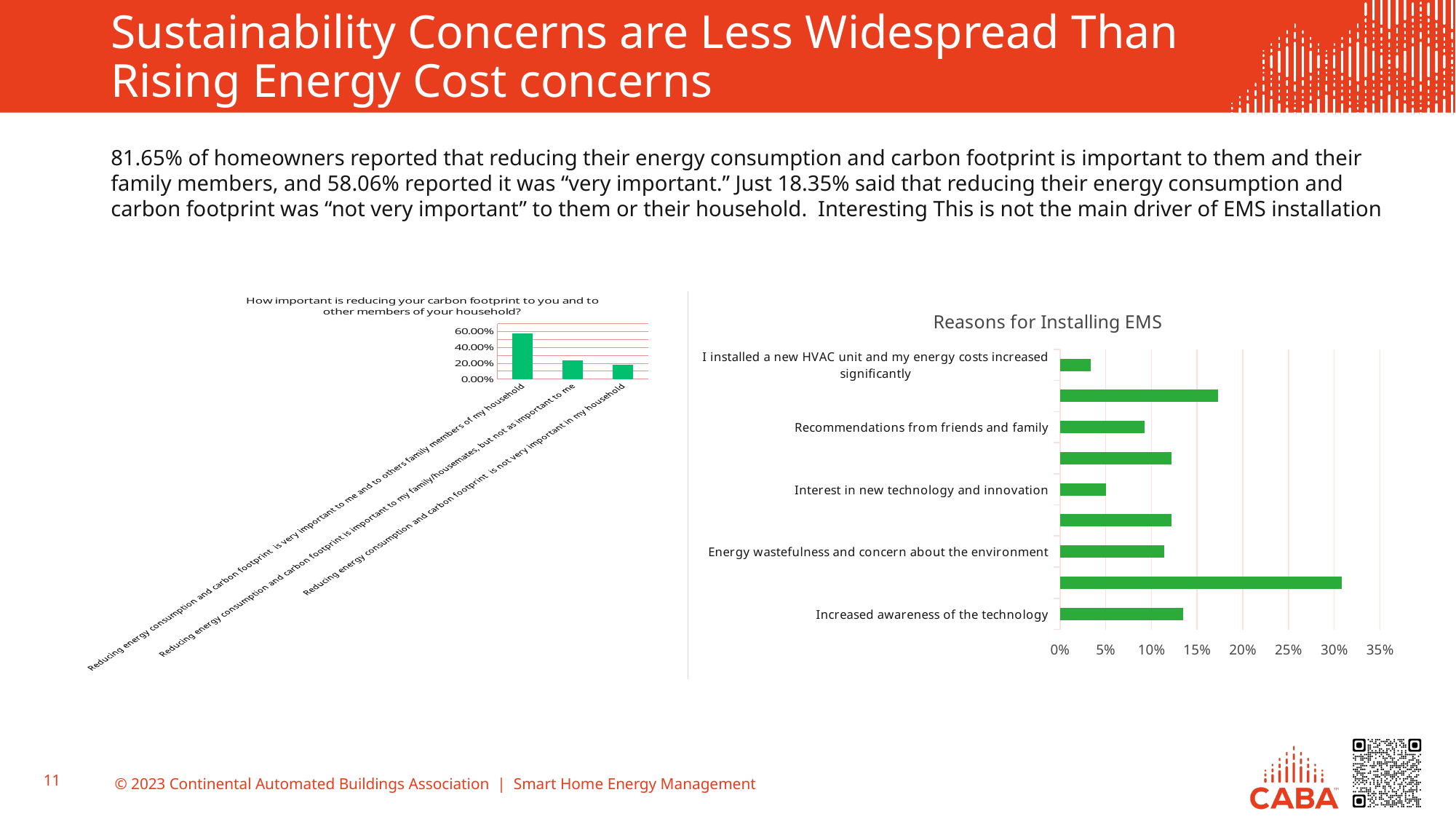
In the 'Reasons for Installing EMS' chart, is the value for 'Increased awareness of the technology' greater or less than 15%? less In the chart on the left ('How important is reducing your carbon footprint...'), is the value for the first bar ('very important to me and to others family members of my household') greater or less than 40.00%? greater In the 'Reasons for Installing EMS' chart, which labelled reason has the shortest bar? I installed a new HVAC unit and my energy costs increased significantly What kind of chart is the 'Reasons for Installing EMS' chart? Bar chart What is the title of the chart on the right of the slide? Reasons for Installing EMS In the 'Reasons for Installing EMS' chart, which is larger: 'Increased awareness of the technology' or 'Interest in new technology and innovation'? Increased awareness of the technology In the chart on the left ('How important is reducing your carbon footprint...'), do the bar values rise or fall from left to right? fall In the 'Reasons for Installing EMS' chart, is the value for 'I installed a new HVAC unit and my energy costs increased significantly' greater or less than 5%? less How many bars are plotted in the chart on the left ('How important is reducing your carbon footprint...')? 3